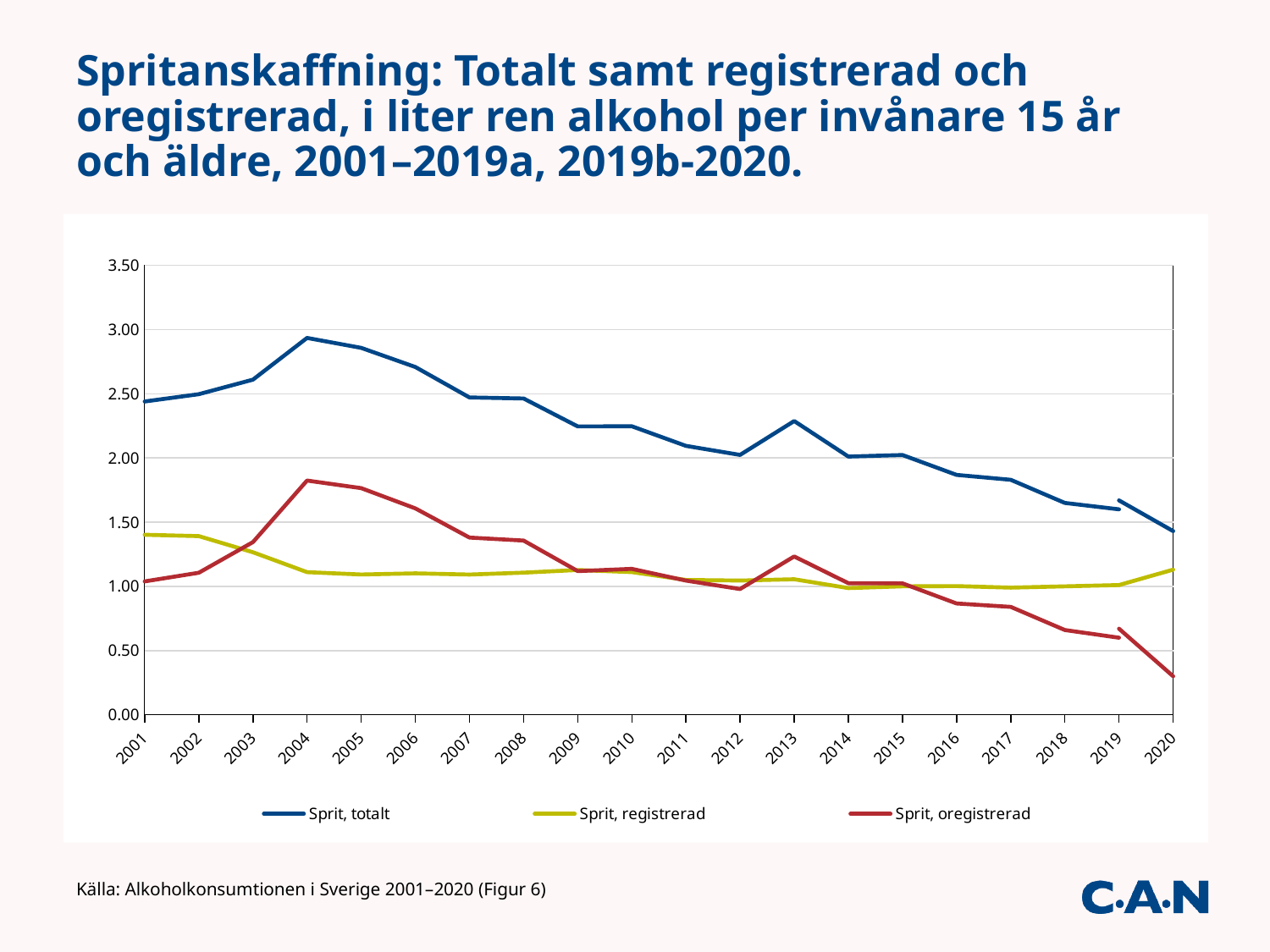
Is the value for 'Sprit, registrerad' in 2001 greater or less than 1.00? greater What colour is the line for 'Sprit, registrerad'? Yellow How many series does the legend list? 3 Does the 'Sprit, totalt' series rise or fall from 2004 to 2020? Fall Is the value for 'Sprit, totalt' in 2004 greater or less than 2.50? greater In which year does the 'Sprit, oregistrerad' series reach its highest value? 2004 In which year does the 'Sprit, oregistrerad' series reach its lowest value? 2020 In 2004, which is larger: 'Sprit, registrerad' or 'Sprit, oregistrerad'? Sprit, oregistrerad How many years are shown on the x axis? 20 Is the value for 'Sprit, oregistrerad' in 2020 greater or less than 0.50? less In which year does the 'Sprit, totalt' series reach its highest value? 2004 What kind of chart is shown on the slide? Line chart